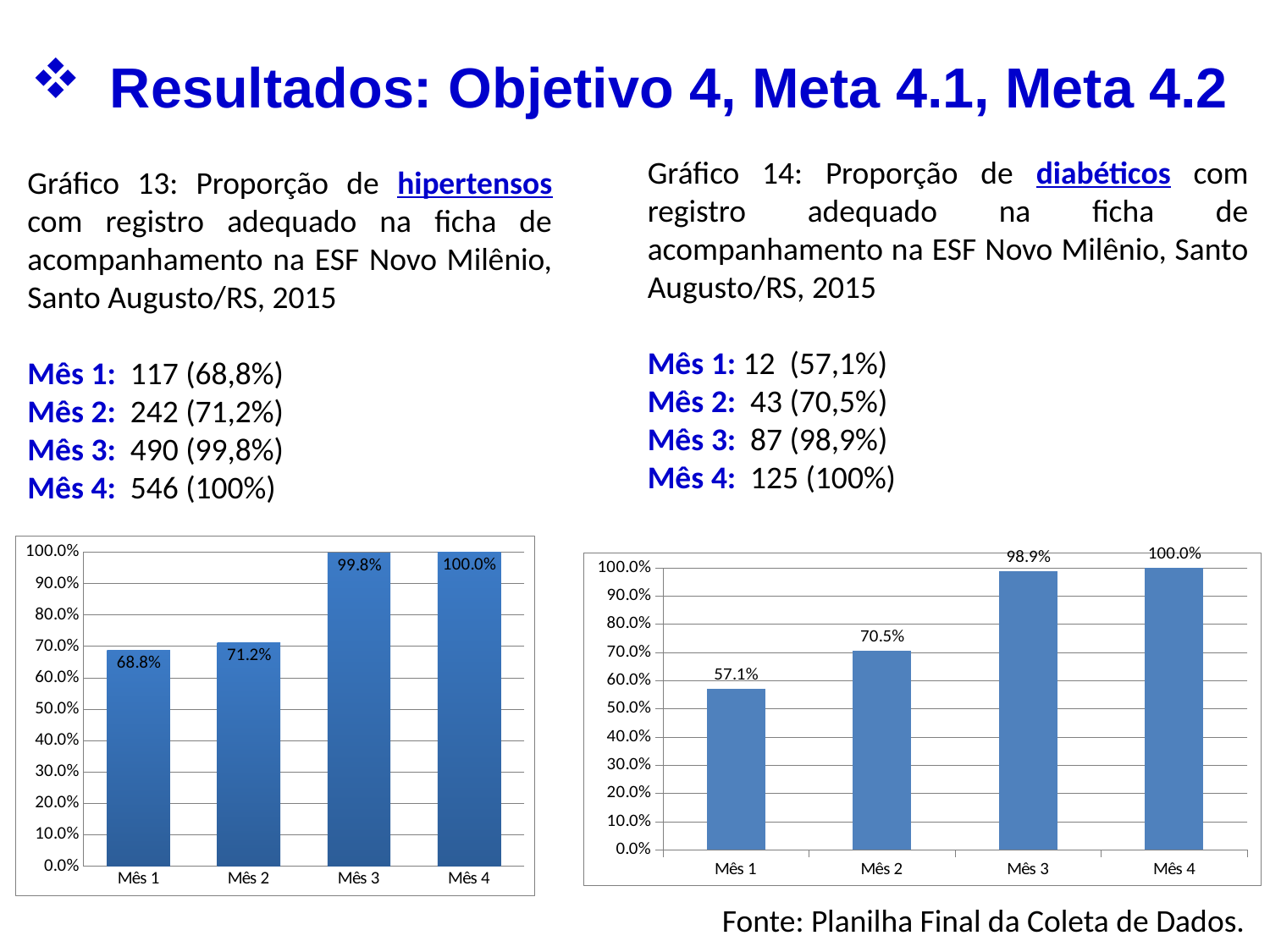
In the right chart (Gráfico 14, diabéticos), what is the difference between the values for Mês 3 and Mês 2? 28.4% In the right chart (Gráfico 14, diabéticos), which month has the lowest value? Mês 1 In the left chart (Gráfico 13, hipertensos), what is the difference between the values for Mês 2 and Mês 1? 2.4% What kind of chart is the right chart (Gráfico 14, diabéticos)? bar chart In the left chart (Gráfico 13, hipertensos), what is the value for Mês 3? 99.8% In the left chart (Gráfico 13, hipertensos), which month has the highest value? Mês 4 In the right chart (Gráfico 14, diabéticos), which is larger, the value for Mês 1 or Mês 2? Mês 2 How many bars are plotted in the left chart (Gráfico 13, hipertensos)? 4 In the right chart (Gráfico 14, diabéticos), what is the value for Mês 2? 70.5% In the left chart (Gráfico 13, hipertensos), what is the value for Mês 1? 68.8% In the right chart (Gráfico 14, diabéticos), what is the value for Mês 1? 57.1% In the right chart (Gráfico 14, diabéticos), do the values rise or fall from Mês 1 to Mês 4? rise